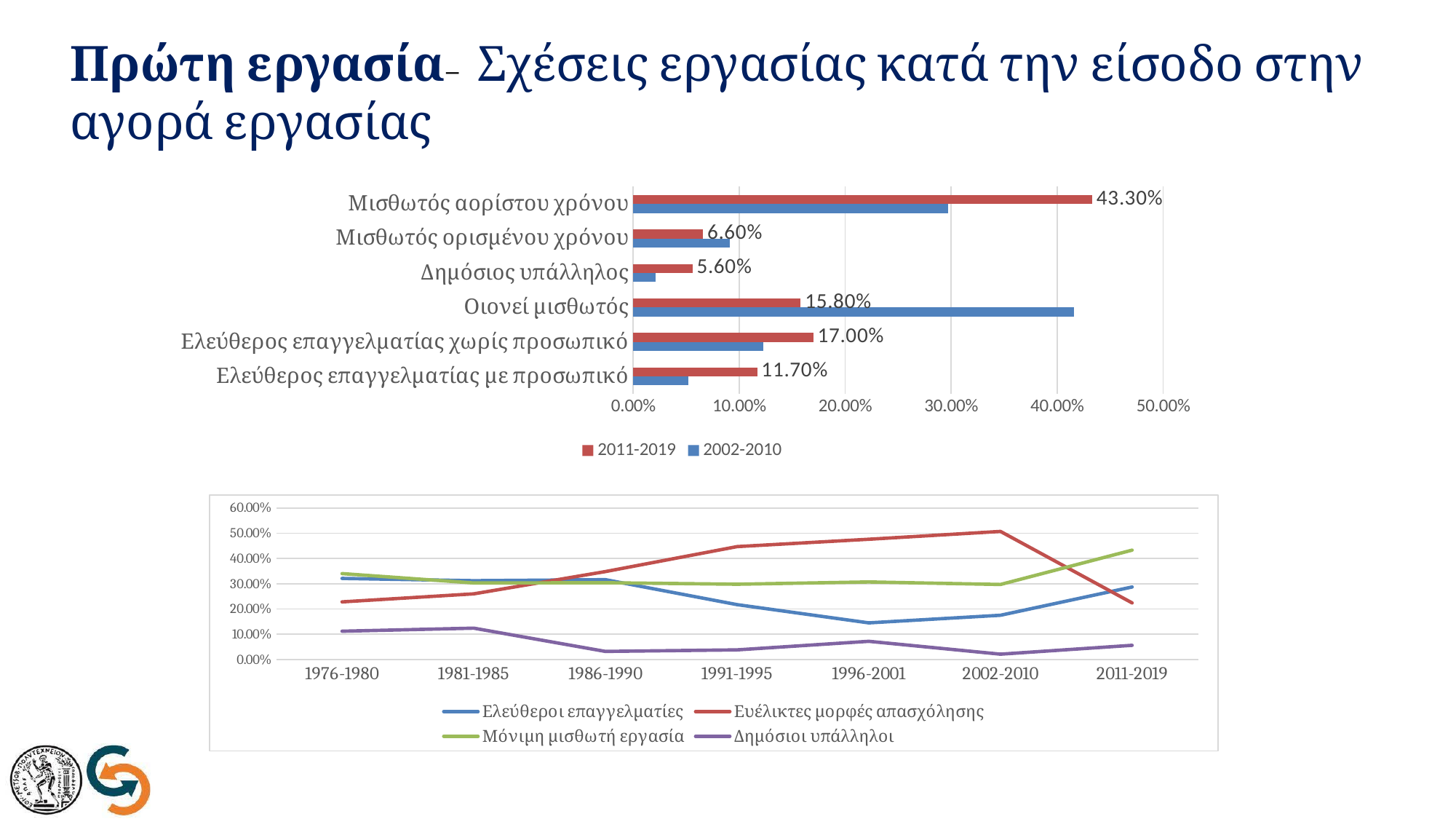
In the bottom line chart, which series has the highest value at 2011-2019? Μόνιμη μισθωτή εργασία How many series does the legend of the top bar chart list? 2 In the top bar chart, what is the difference between the 2011-2019 values for Ελεύθερος επαγγελματίας χωρίς προσωπικό and Ελεύθερος επαγγελματίας με προσωπικό? 5.30% How many series does the legend of the bottom line chart list? 4 In the top bar chart, which category has the lowest 2011-2019 value? Δημόσιος υπάλληλος In the top bar chart, is the 2002-2010 value for Μισθωτός αορίστου χρόνου greater or less than 20.00%? greater In the top bar chart, for the 2002-2010 series, which is larger: Οιονεί μισθωτός or Μισθωτός αορίστου χρόνου? Οιονεί μισθωτός In the top bar chart, what is the 2011-2019 value for Οιονεί μισθωτός? 15.80% In the top bar chart, which category has the highest 2011-2019 value? Μισθωτός αορίστου χρόνου What kind of chart is the bottom chart on the slide? line chart How many categories does the top bar chart show? 6 In the top bar chart, what is the 2011-2019 value for Μισθωτός αορίστου χρόνου? 43.30%